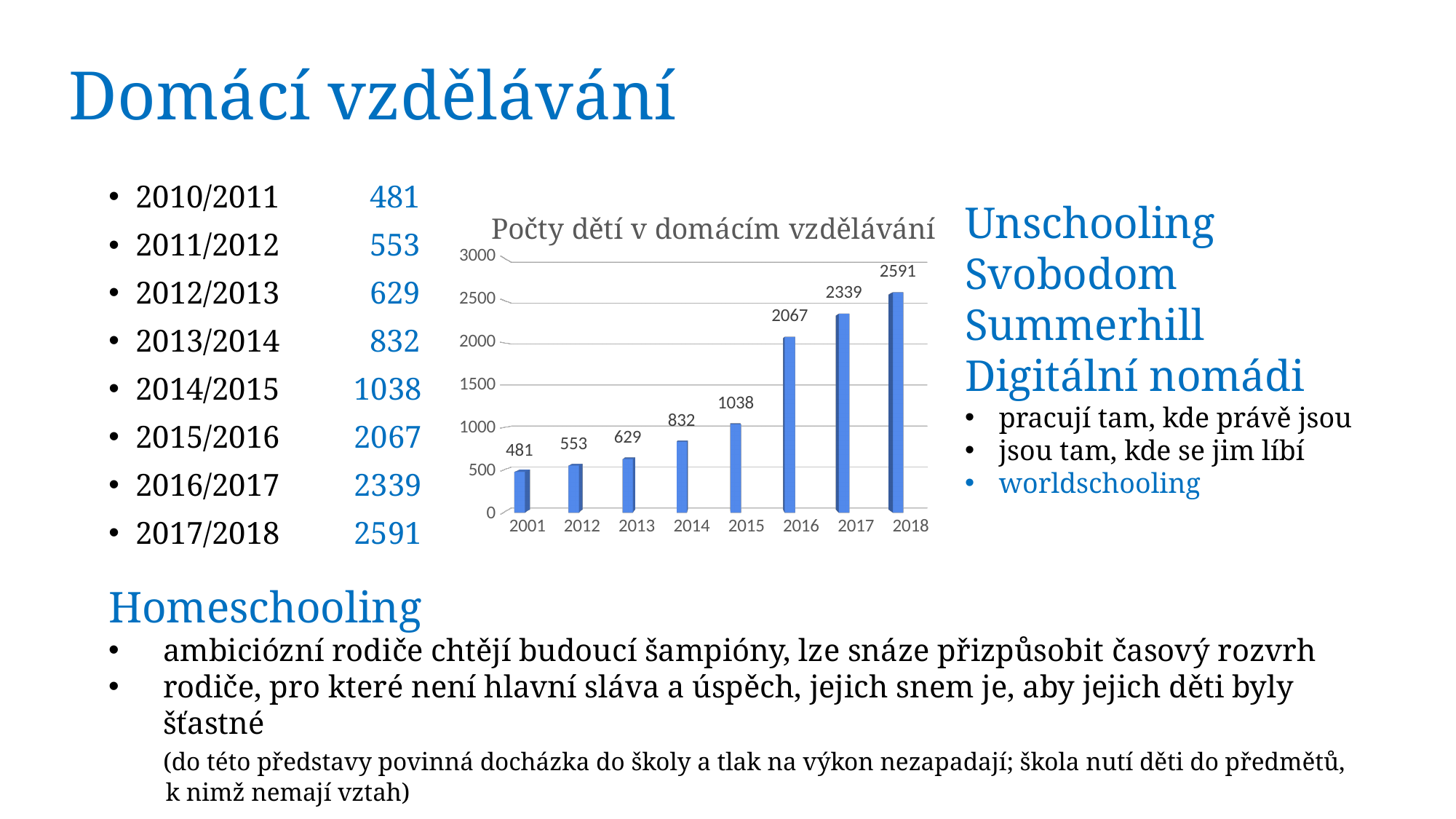
What is the value for 2016 in the chart? 2067 What type of chart is shown on the slide? bar chart What is the value for 2018 in the chart? 2591 Which is larger, the value for 2013 or the value for 2012? 2013 Which category has the lowest value in the chart? 2001 How many bars are in the chart? 8 What is the title of the chart? Počty dětí v domácím vzdělávání What is the value for 2014 in the chart? 832 What is the difference between the values for 2015 and 2014? 206 Which year has the highest value in the chart? 2018 What is the difference between the values for 2017 and 2016? 272 Do the values rise or fall from left to right along the x axis? rise